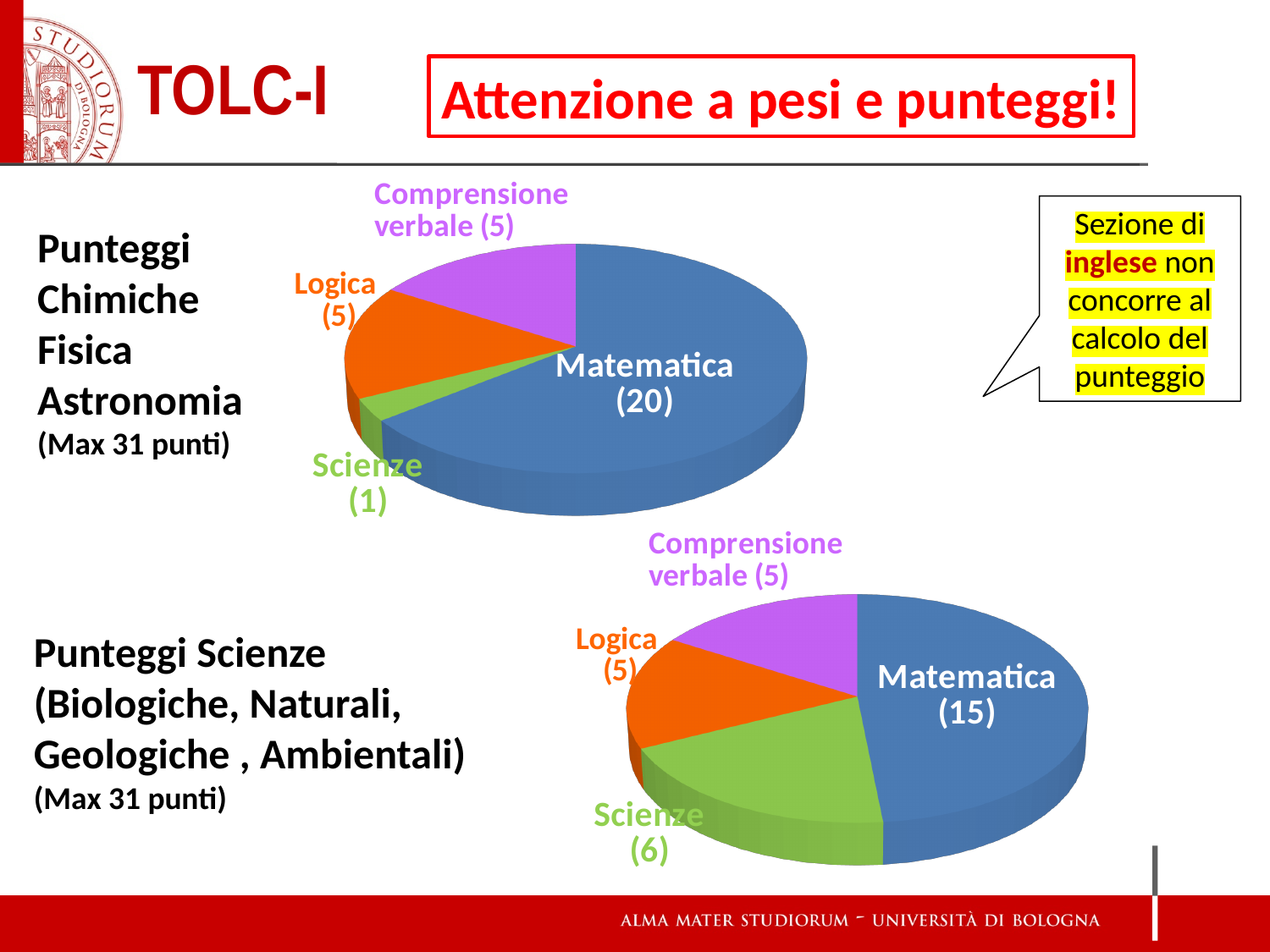
How many categories does the top pie chart show? 4 In the bottom pie chart, what is the difference between the values for Matematica and Scienze? 9 In the bottom pie chart, what is the value for Matematica? 15 In the top pie chart, what is the value for Matematica? 20 What kind of chart is the bottom chart? Pie chart In the top pie chart, which category has the smallest slice? Scienze In the top pie chart, which is larger, Logica or Scienze? Logica In the top pie chart, which category has the largest slice? Matematica What is the total of all the values shown in the bottom pie chart? 31 In the bottom pie chart, what is the value for Scienze? 6 How much larger is the Matematica value in the top pie chart than in the bottom pie chart? 5 In the top pie chart, what is the value for Scienze? 1